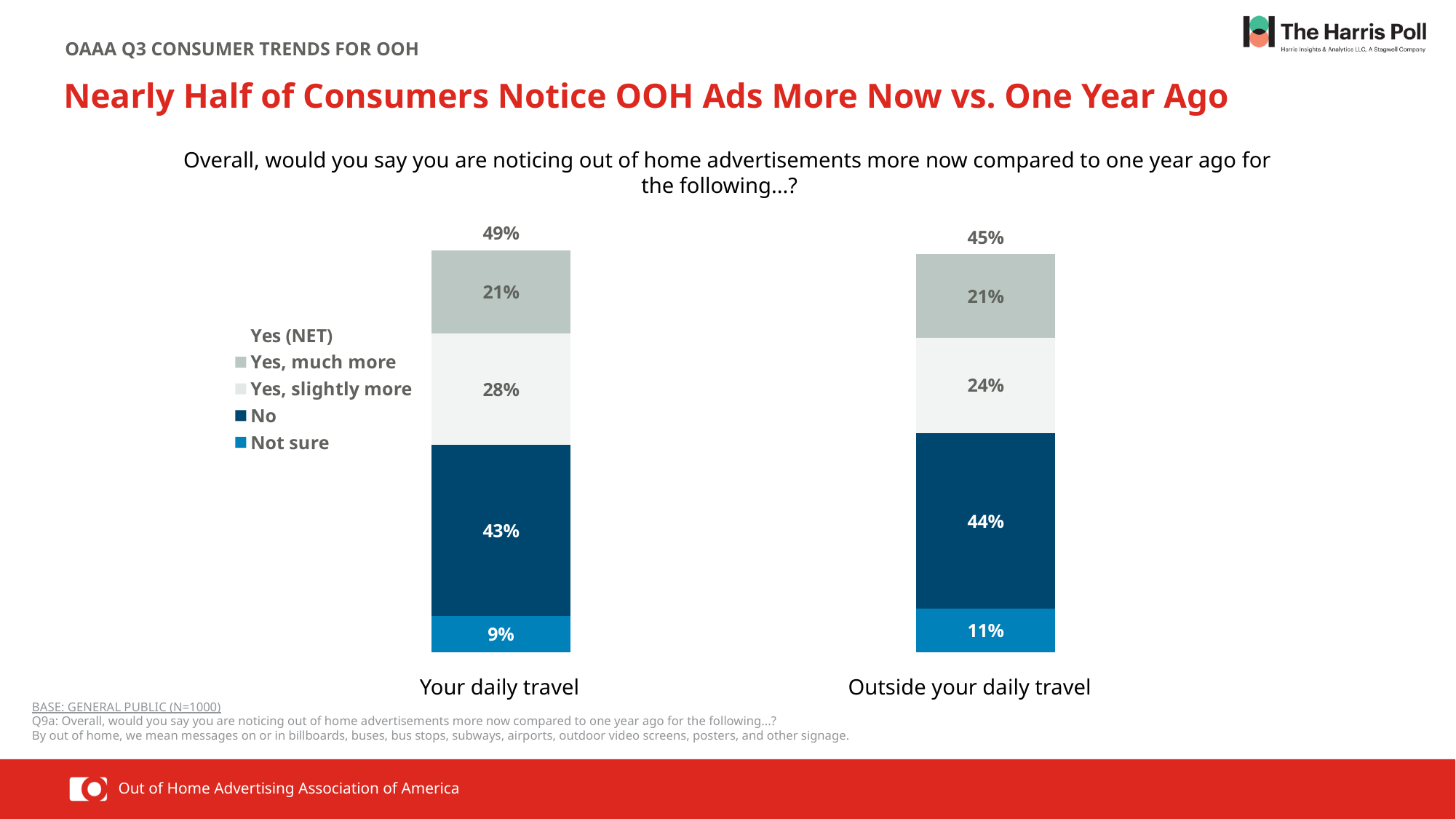
What kind of chart is shown on the slide? Stacked bar chart What percentage of respondents said "No" for "Your daily travel"? 43% Which segment is the smallest in the "Your daily travel" bar? Not sure What is the difference between the "Yes, slightly more" values for "Your daily travel" and "Outside your daily travel"? 4 percentage points How many categories (bars) are shown in the chart? 2 What is the difference between the Yes (NET) figures for the two categories? 4 percentage points What is the "Yes, much more" value for "Outside your daily travel"? 21% What is the "Not sure" value for "Outside your daily travel"? 11% What is the Yes (NET) figure shown above the "Outside your daily travel" bar? 45% Which category has the higher Yes (NET) figure, "Your daily travel" or "Outside your daily travel"? Your daily travel Which segment is the largest in the "Outside your daily travel" bar? No What is the "Yes, slightly more" value for "Your daily travel"? 28%